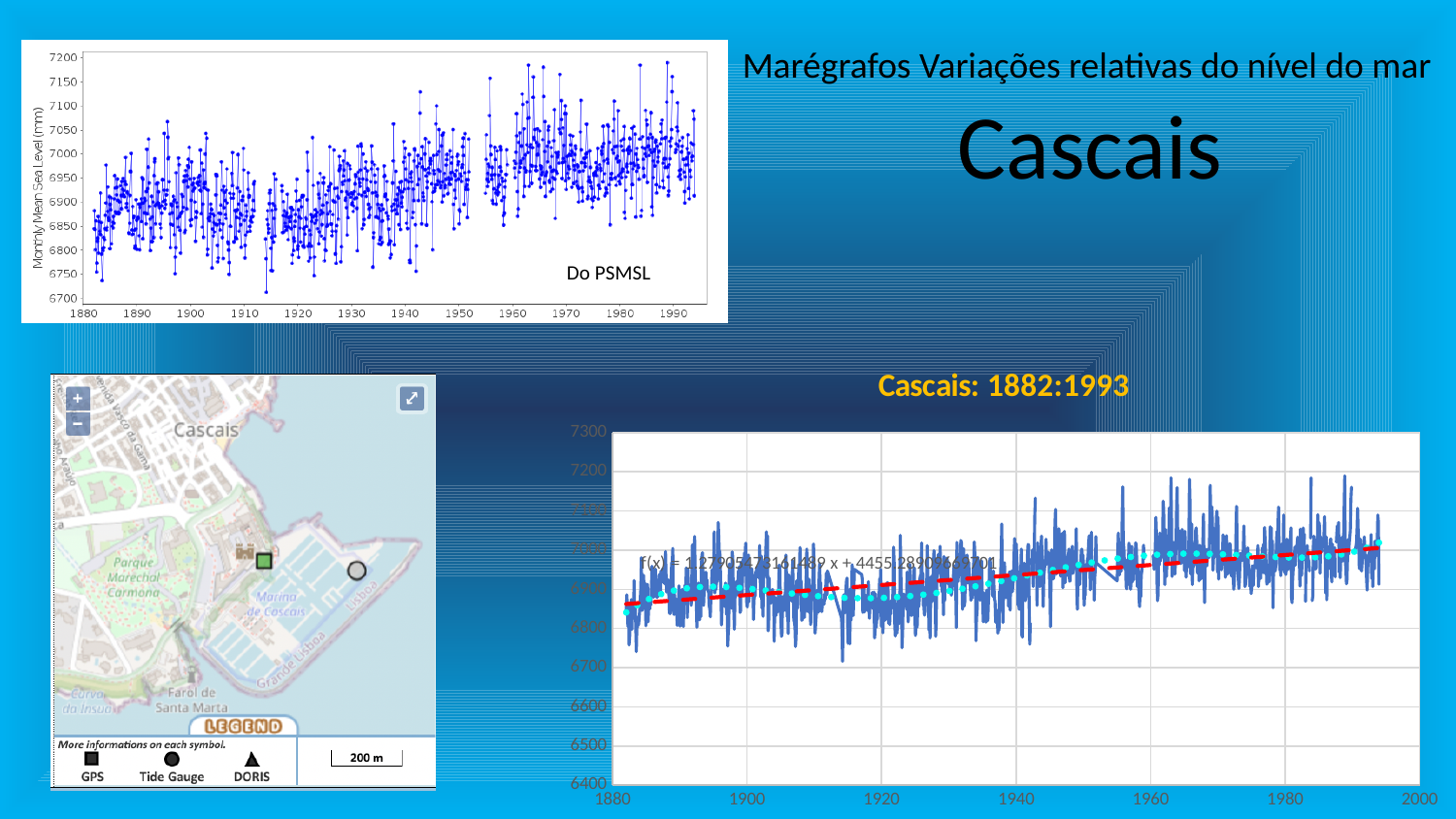
In the bottom-right chart titled 'Cascais: 1882:1993', what is the lowest value shown on the y axis? 6400 In the bottom-right chart titled 'Cascais: 1882:1993', is the trend line value at the start of the series (around 1882) greater or less than 7000? less In the top-left chart, is the highest plotted monthly value greater or less than 7150? greater In the bottom-right chart titled 'Cascais: 1882:1993', does the dashed trend line rise or fall from 1880 to 2000? rise What is the title of the chart at the bottom right of the slide? Cascais: 1882:1993 In the top-left chart, do the monthly mean sea level values generally rise or fall from 1880 to 1990? rise What is the y-axis label of the chart at the top left of the slide? Monthly Mean Sea Level (mm) In the bottom-right chart titled 'Cascais: 1882:1993', is the trend line value at the end of the series (around 1993) greater or less than 6900? greater What kind of chart is the chart at the bottom right of the slide? line chart